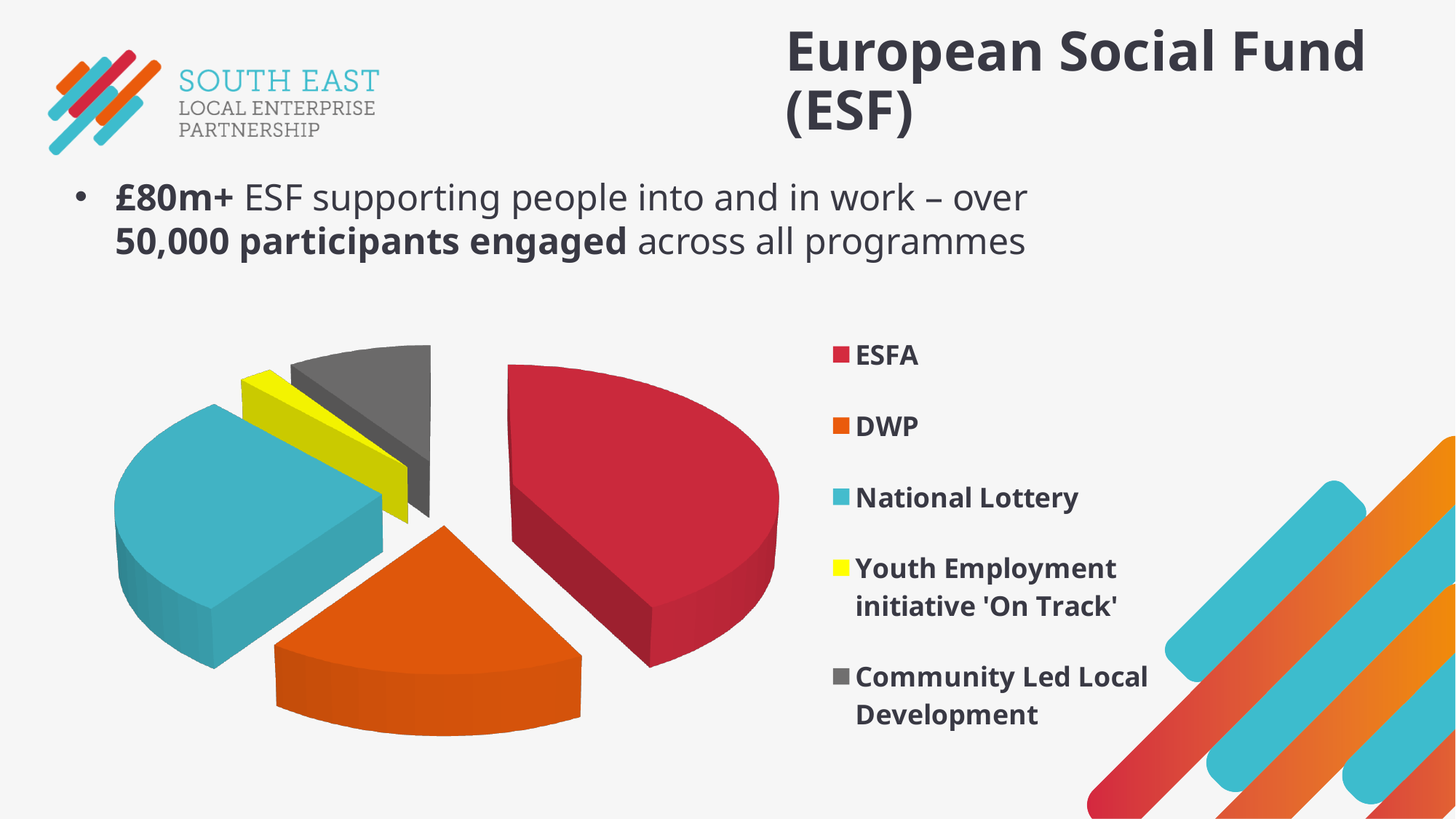
Which category is shown in grey in the pie chart? Community Led Local Development What kind of chart is shown on the slide? pie chart What colour is the National Lottery slice in the pie chart? blue Which slice is larger in the pie chart, National Lottery or Community Led Local Development? National Lottery Which category has the smallest slice of the pie chart? Youth Employment initiative 'On Track' Which slice is larger in the pie chart, Community Led Local Development or Youth Employment initiative 'On Track'? Community Led Local Development Which slice is larger in the pie chart, ESFA or DWP? ESFA How many slices does the pie chart have? 5 How many entries does the pie chart's legend list? 5 Which category has the largest slice of the pie chart? ESFA